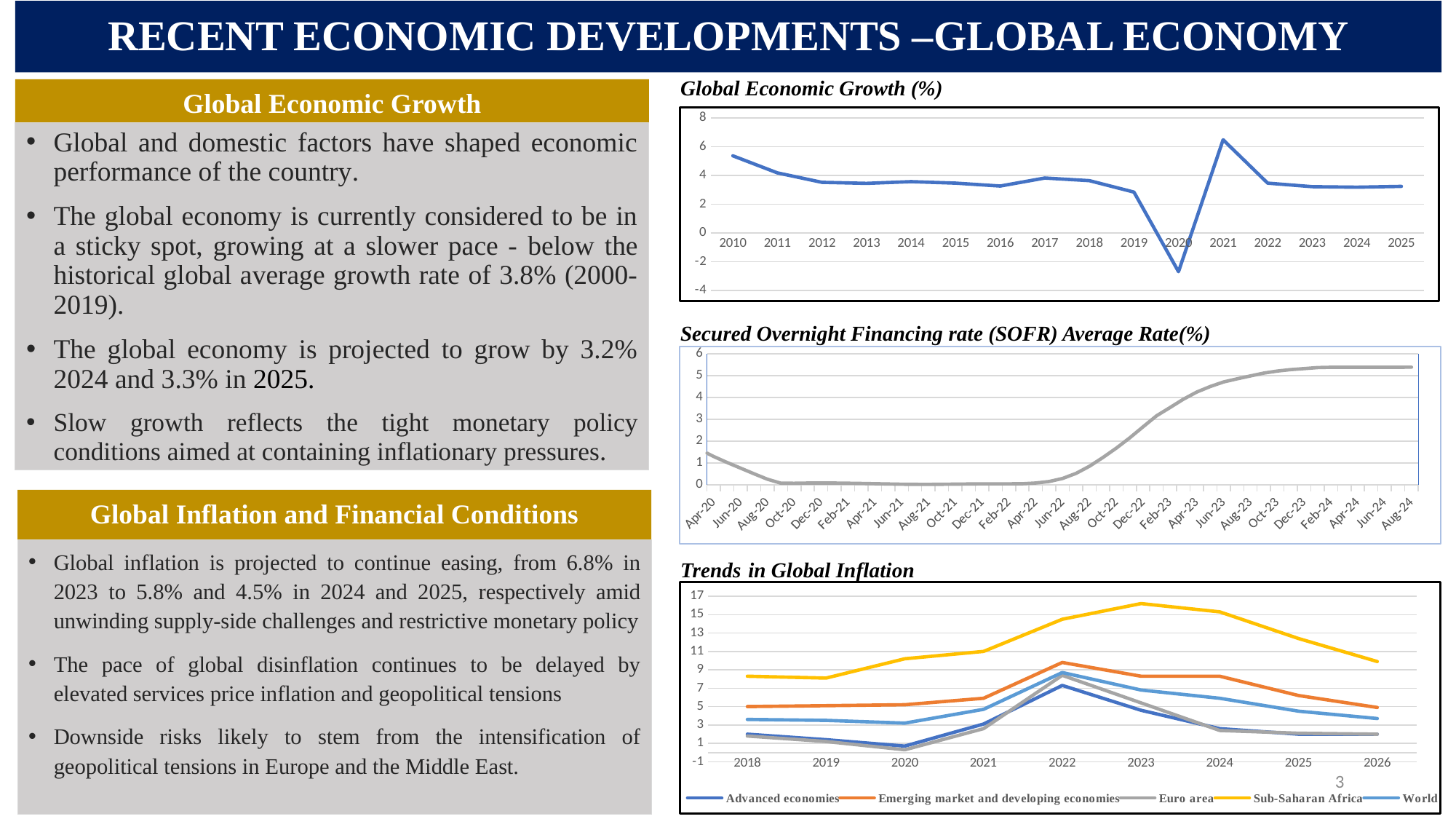
In the 'Global Economic Growth (%)' chart, which year has the highest value? 2021 In the 'Global Economic Growth (%)' chart, which year has the lowest value? 2020 What kind of chart is the 'Global Economic Growth (%)' chart? line chart In the 'Global Economic Growth (%)' chart, is the value for 2020 greater or less than 0? less How many series does the legend of the 'Trends in Global Inflation' chart list? 5 In the 'Global Economic Growth (%)' chart, is the value for 2021 greater or less than 6? greater In the 'Secured Overnight Financing rate (SOFR) Average Rate(%)' chart, is the value for Apr-20 greater or less than 1? greater How many years are plotted on the x axis of the 'Global Economic Growth (%)' chart? 16 In the 'Secured Overnight Financing rate (SOFR) Average Rate(%)' chart, does the value rise or fall between Jun-22 and Jun-23? rise In the 'Trends in Global Inflation' chart, which series has the highest value in 2022? Sub-Saharan Africa